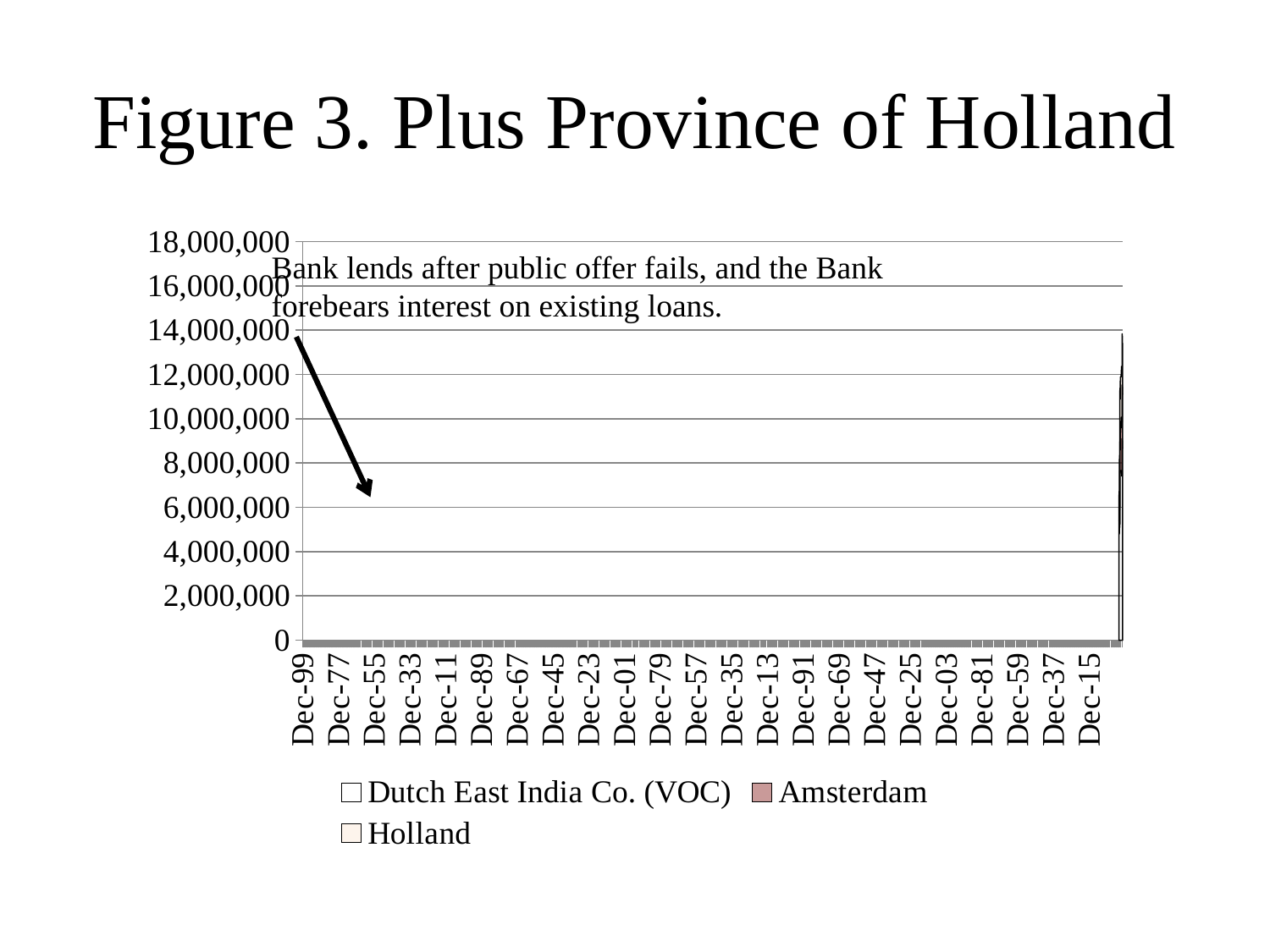
What is the first label on the x axis? Dec-99 What is the highest value shown on the y axis? 18,000,000 Is the peak value reached at the right end of the chart greater or less than 10,000,000? greater What is the last label on the x axis? Dec-15 How many series does the legend list? 3 Across most of the x axis, do the plotted values stay near zero or rise steadily? stay near zero Where along the x axis does the sharp spike in values occur: at the left end, in the middle, or at the right end? at the right end What is the title of the slide containing the chart? Figure 3. Plus Province of Holland What are the three series named in the legend? Dutch East India Co. (VOC), Amsterdam, Holland Is the peak value reached at the right end of the chart greater or less than 16,000,000? less